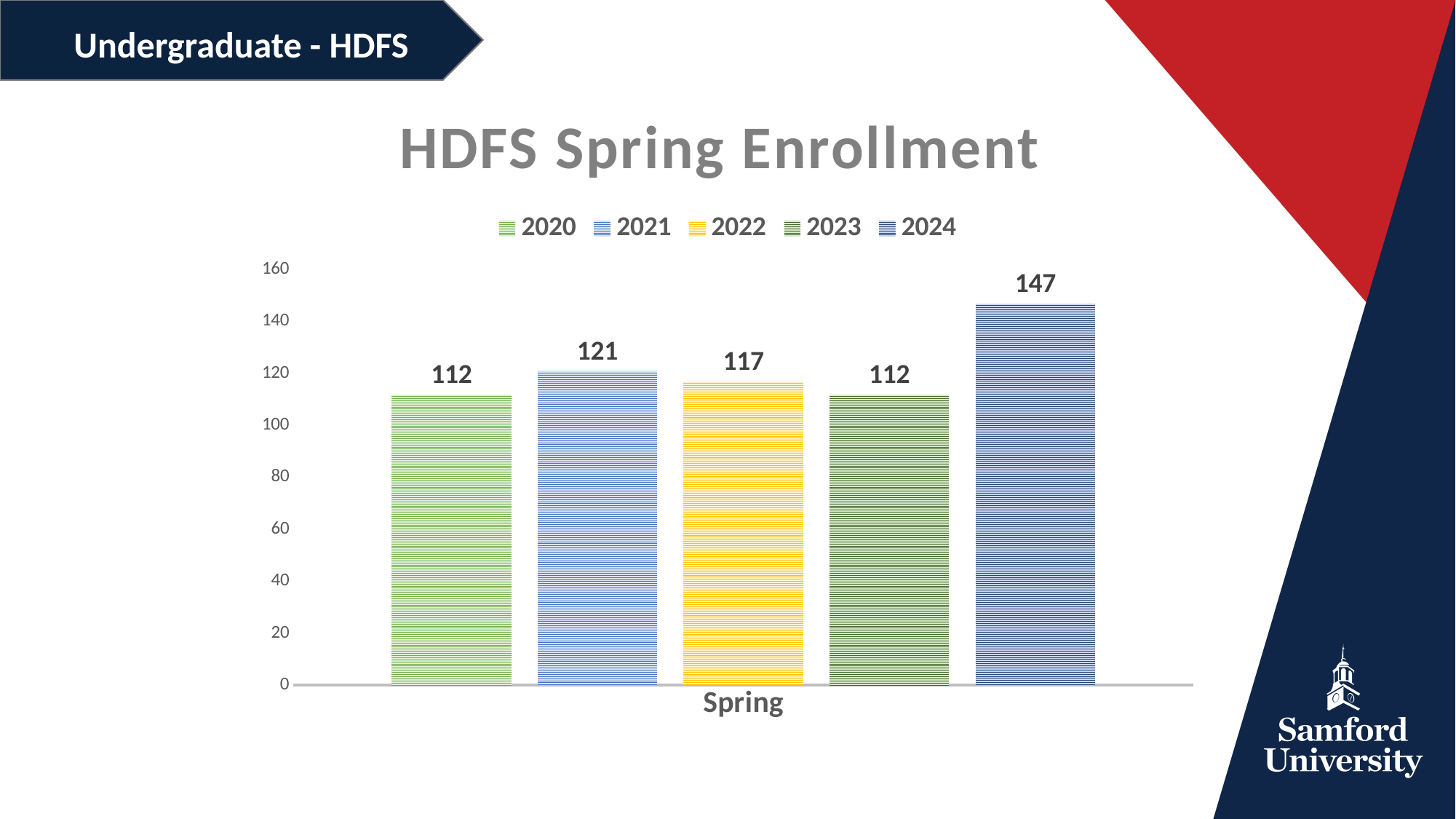
What is the HDFS spring enrollment for 2021? 121 What is the difference in HDFS spring enrollment between 2021 and 2022? 4 What is the HDFS spring enrollment for 2022? 117 What is the title of the chart? HDFS Spring Enrollment What is the HDFS spring enrollment for 2020? 112 Which year has the larger HDFS spring enrollment, 2021 or 2022? 2021 What is the difference in HDFS spring enrollment between 2024 and 2023? 35 What kind of chart is shown on the slide? Bar chart What is the HDFS spring enrollment for 2024? 147 Is the HDFS spring enrollment for 2024 greater or less than 140? greater Which year has the highest HDFS spring enrollment? 2024 How many series does the legend list? 5